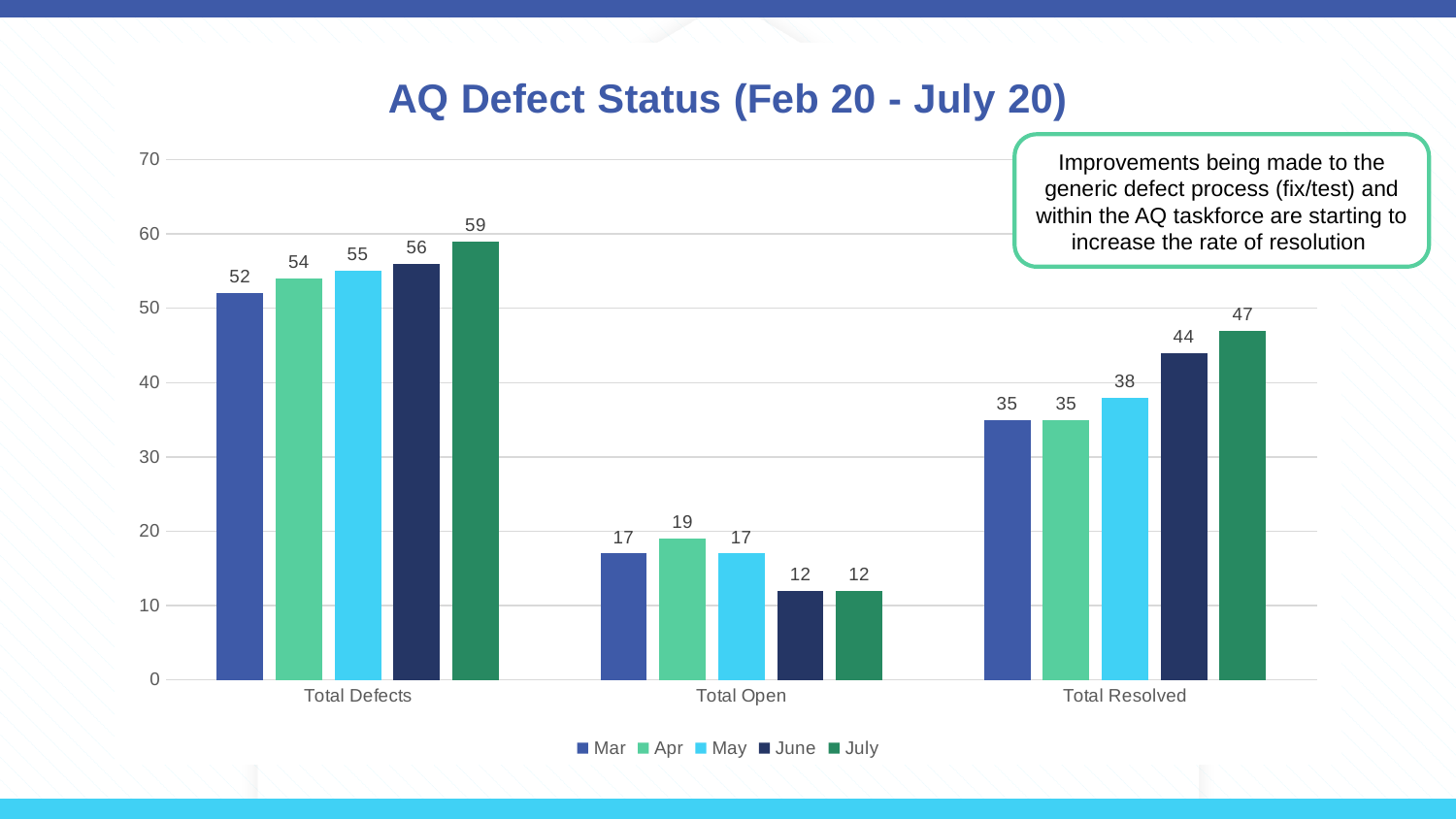
How many categories are shown on the x axis? 3 How many series does the legend list? 5 Do the Total Defects values rise or fall from Mar to July? Rise What is the value for May in the Total Resolved category? 38 What kind of chart is shown on the slide? Bar chart What is the value for July in the Total Defects category? 59 What is the title of the chart? AQ Defect Status (Feb 20 - July 20) What is the value for Apr in the Total Open category? 19 What is the difference between the July and Mar values in the Total Resolved category? 12 Which month has the highest value in the Total Resolved category? July Which month has the lowest value in the Total Defects category? Mar Which is larger in the Total Open category, the Mar value or the June value? Mar